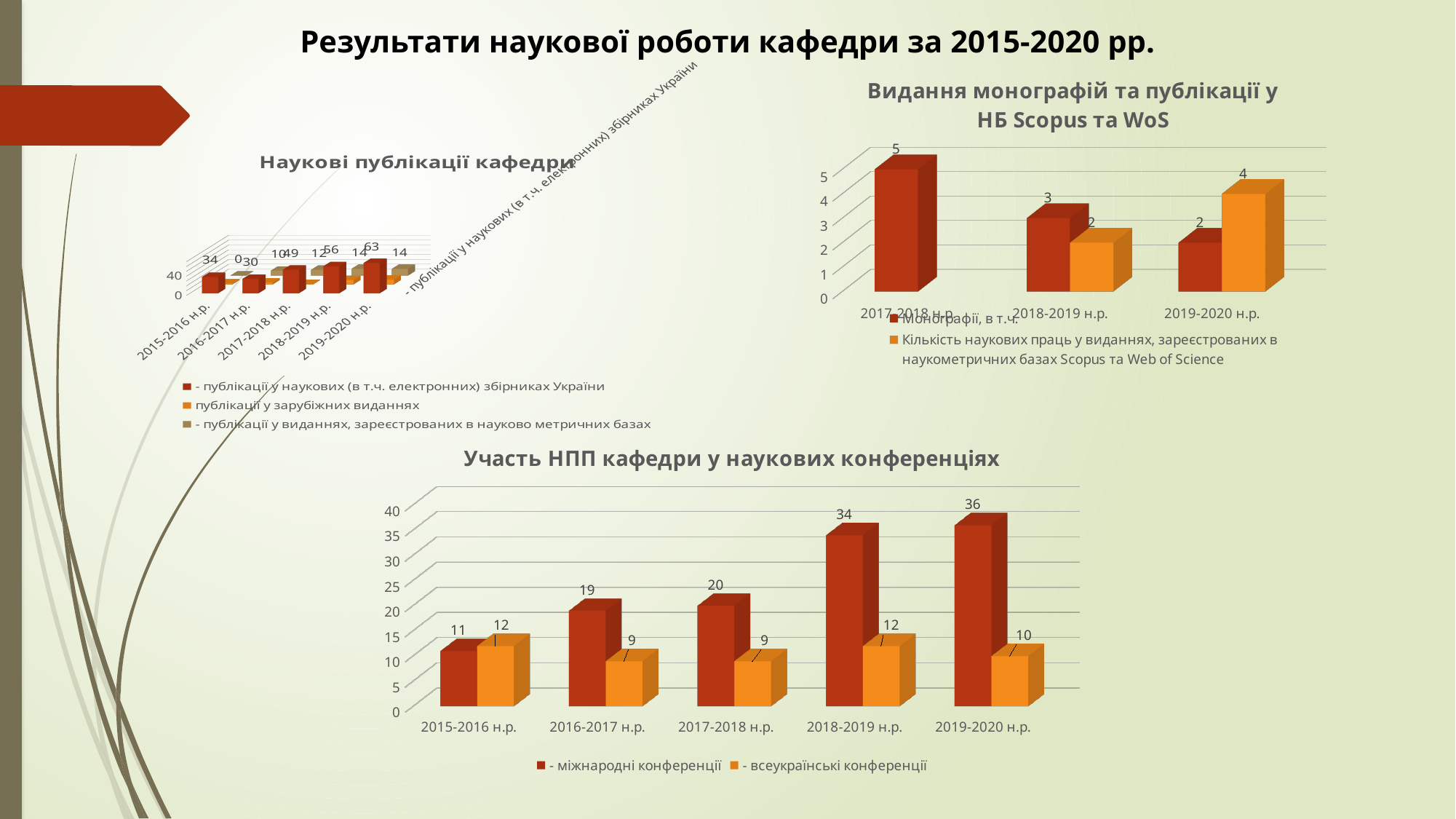
In the chart 'Участь НПП кафедри у наукових конференціях', which year has the lowest value for міжнародні конференції? 2015-2016 н.р. In the chart 'Участь НПП кафедри у наукових конференціях', which year has the highest value for міжнародні конференції? 2019-2020 н.р. In the chart 'Участь НПП кафедри у наукових конференціях', what is the difference between міжнародні конференції and всеукраїнські конференції in 2018-2019 н.р.? 22 In the chart 'Участь НПП кафедри у наукових конференціях', which is larger in 2015-2016 н.р.: міжнародні конференції or всеукраїнські конференції? всеукраїнські конференції In the chart 'Видання монографій та публікації у НБ Scopus та WoS', what is the value for the Scopus and Web of Science series in 2019-2020 н.р.? 4 In the chart 'Видання монографій та публікації у НБ Scopus та WoS', what is the value for Монографії in 2017-2018 н.р.? 5 In the chart 'Участь НПП кафедри у наукових конференціях', what is the value for всеукраїнські конференції in 2015-2016 н.р.? 12 In the chart 'Видання монографій та публікації у НБ Scopus та WoS', which year has the lowest value for Монографії? 2019-2020 н.р. In the chart 'Участь НПП кафедри у наукових конференціях', how many years are shown on the x axis? 5 What kind of chart is 'Участь НПП кафедри у наукових конференціях'? bar chart In the chart 'Участь НПП кафедри у наукових конференціях', does the value for міжнародні конференції rise or fall from 2015-2016 н.р. to 2019-2020 н.р.? rise In the chart 'Участь НПП кафедри у наукових конференціях', what is the value for міжнародні конференції in 2019-2020 н.р.? 36